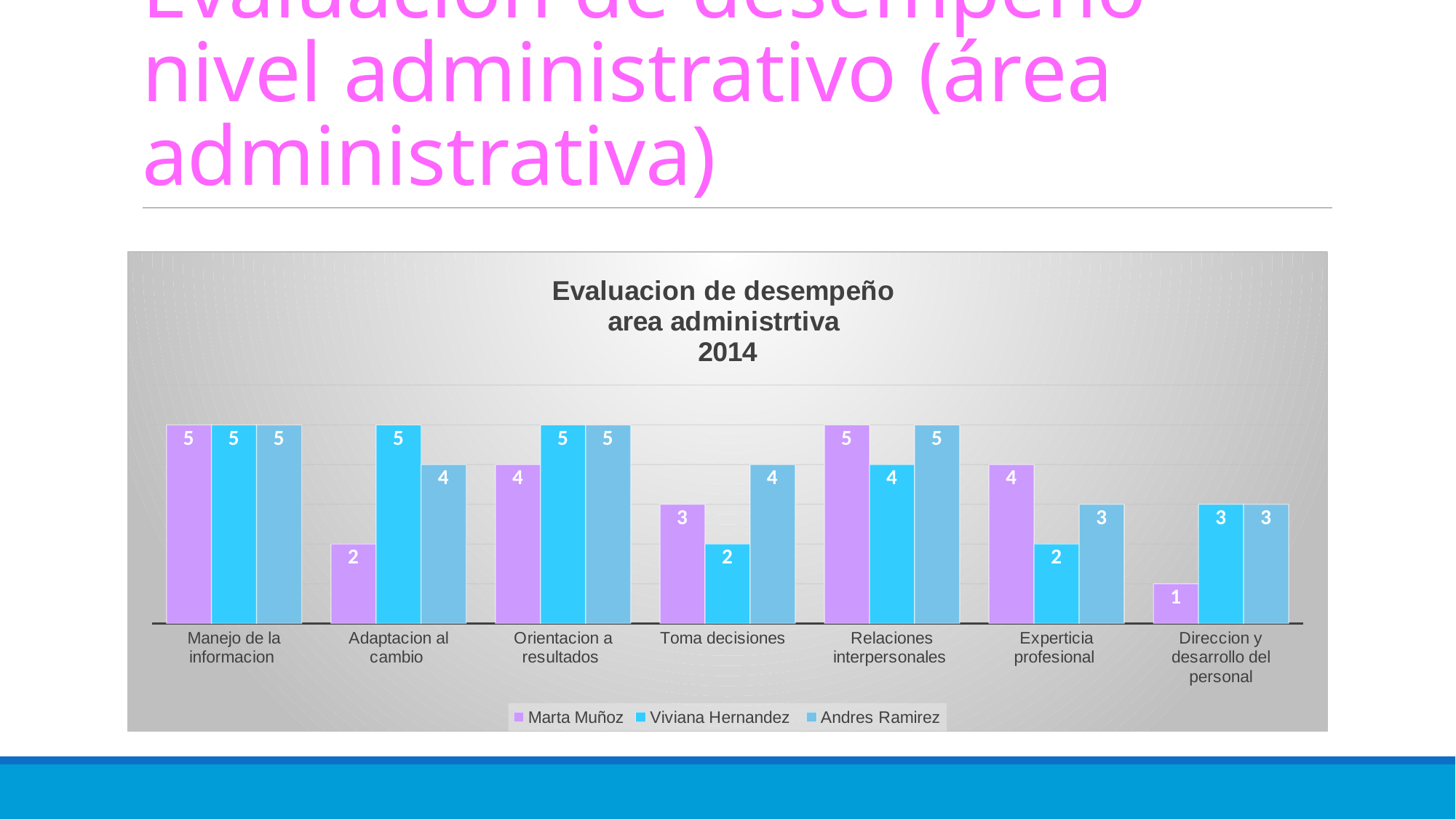
Which category has the lowest value for Marta Muñoz? Direccion y desarrollo del personal What value does Marta Muñoz have for Adaptacion al cambio? 2 How many categories are shown on the x axis? 7 What value does Andres Ramirez have for Experticia profesional? 3 What is the title of the chart? Evaluacion de desempeño area administrtiva 2014 Which series is shown in purple in the legend? Marta Muñoz What value does Viviana Hernandez have for Toma decisiones? 2 What is the difference between Viviana Hernandez and Marta Muñoz for Adaptacion al cambio? 3 How many series does the legend list? 3 What kind of chart is shown on the slide? Bar chart What value does Marta Muñoz have for Direccion y desarrollo del personal? 1 For Relaciones interpersonales, who has the larger value, Viviana Hernandez or Andres Ramirez? Andres Ramirez